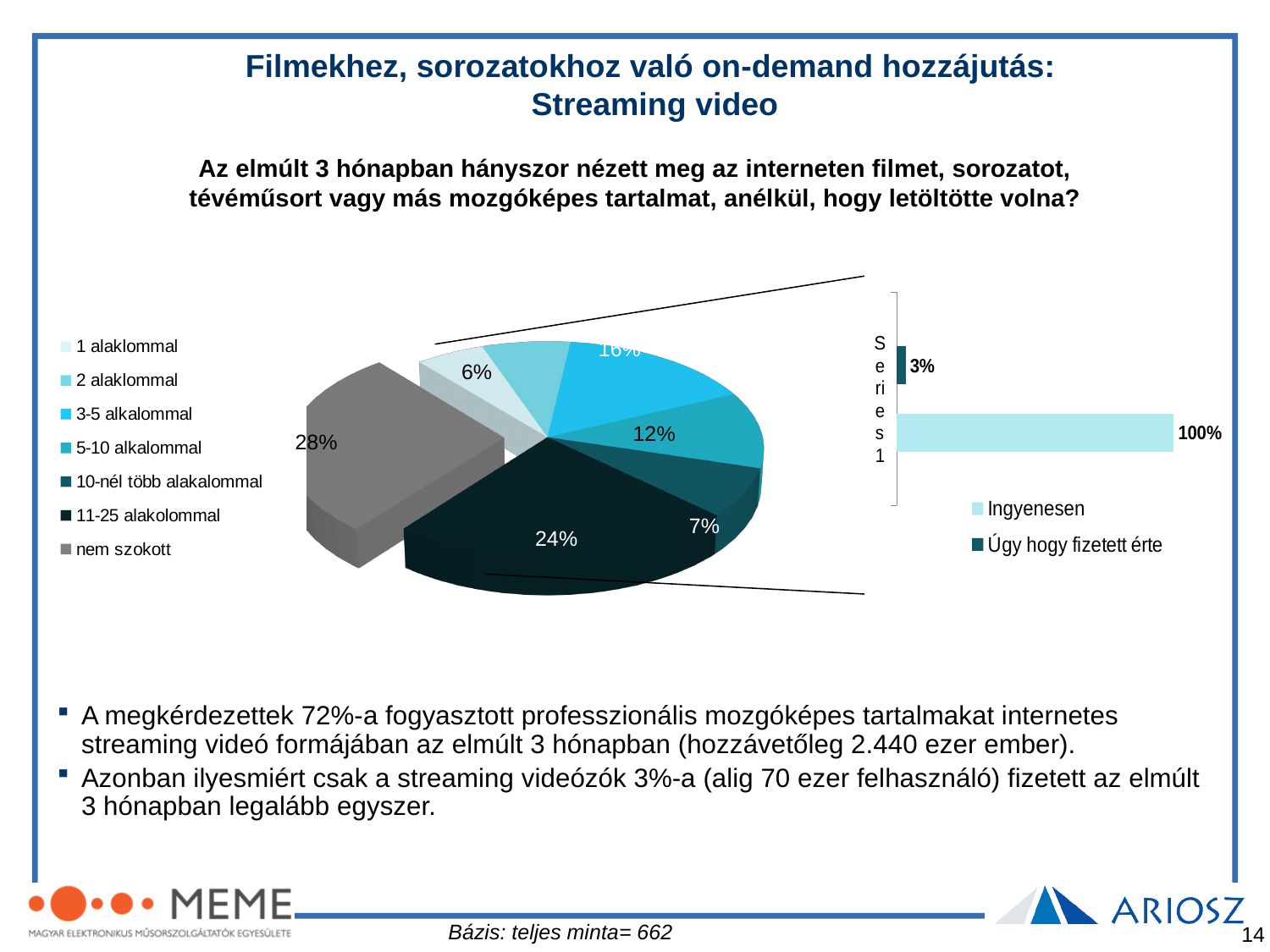
In the bar chart on the right, what is the difference between the 'Ingyenesen' and 'Úgy hogy fizetett érte' values? 97% In the bar chart on the right, what is the value for 'Ingyenesen'? 100% In the pie chart, which category has the largest slice? nem szokott In the pie chart, what share is shown for '11-25 alakolommal'? 24% What kind of chart is the chart in the middle of the slide? pie chart What kind of chart is the chart on the right of the slide? bar chart How many categories does the legend of the pie chart list? 7 In the bar chart on the right, which is larger: 'Ingyenesen' or 'Úgy hogy fizetett érte'? Ingyenesen In the bar chart on the right, what is the value for 'Úgy hogy fizetett érte'? 3% In the pie chart, what share is shown for 'nem szokott'? 28% In the pie chart, which is larger: the '11-25 alakolommal' slice or the '5-10 alkalommal' slice? 11-25 alakolommal How many entries does the legend of the bar chart on the right list? 2